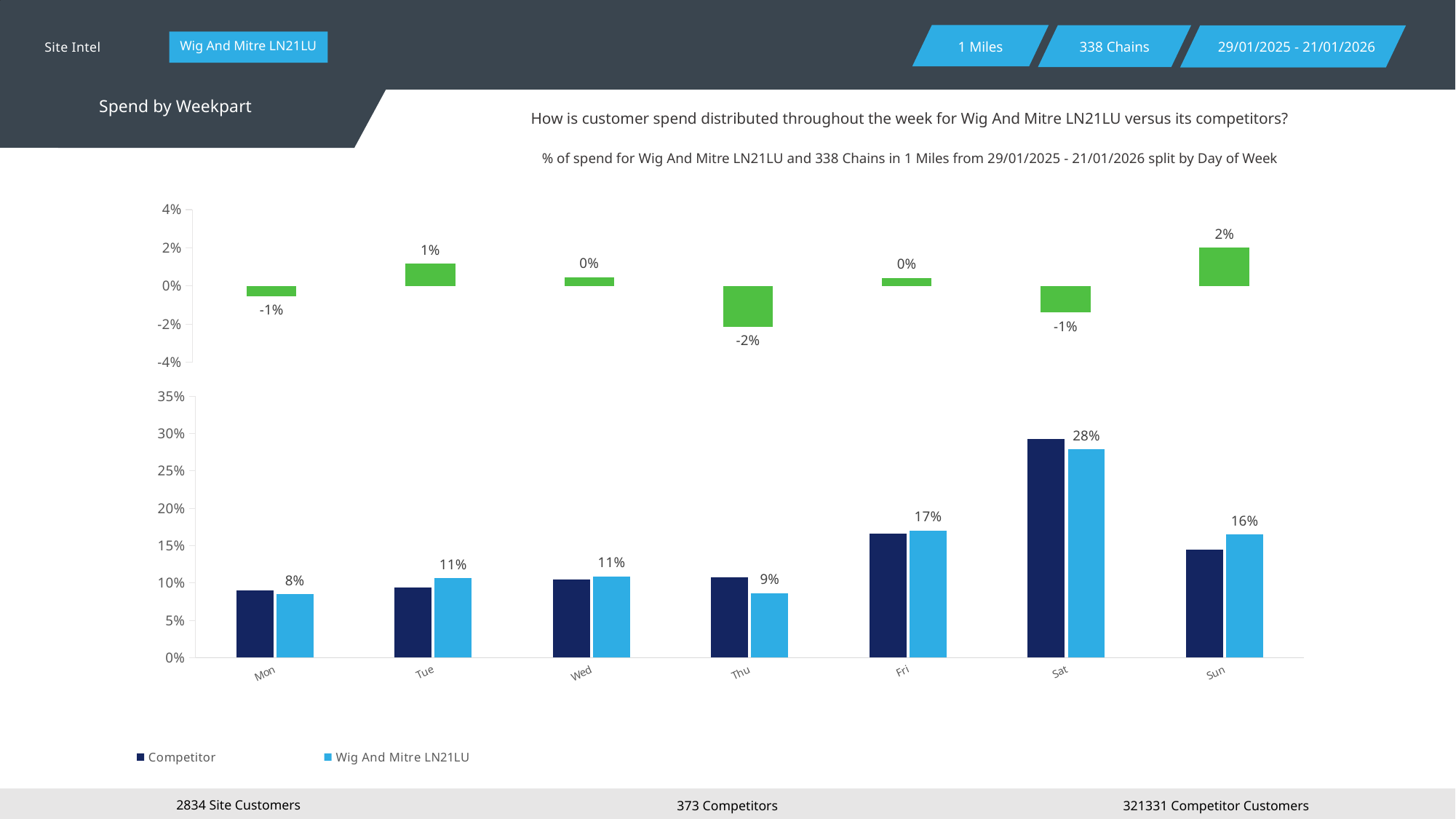
In the bottom chart, what is the value for Wig And Mitre LN21LU on Sat? 28% In the bottom chart, what is the value for Wig And Mitre LN21LU on Fri? 17% In the top chart, what is the value shown for Thu? -2% How many series does the legend of the bottom chart list? 2 In the bottom chart, on which day is the Wig And Mitre LN21LU value lowest? Mon In the bottom chart, on which day is the Wig And Mitre LN21LU value highest? Sat In the bottom chart, is the Competitor value for Mon greater or less than 10%? less In the top chart, which day has the highest value? Sun In the bottom chart, what is the difference between the Wig And Mitre LN21LU values for Sat and Sun? 12% In the bottom chart, which is larger on Sun: the Competitor bar or the Wig And Mitre LN21LU bar? Wig And Mitre LN21LU How many day categories are shown on the x axis of the bottom chart? 7 In the bottom chart, is the Competitor value for Sat greater or less than 25%? greater